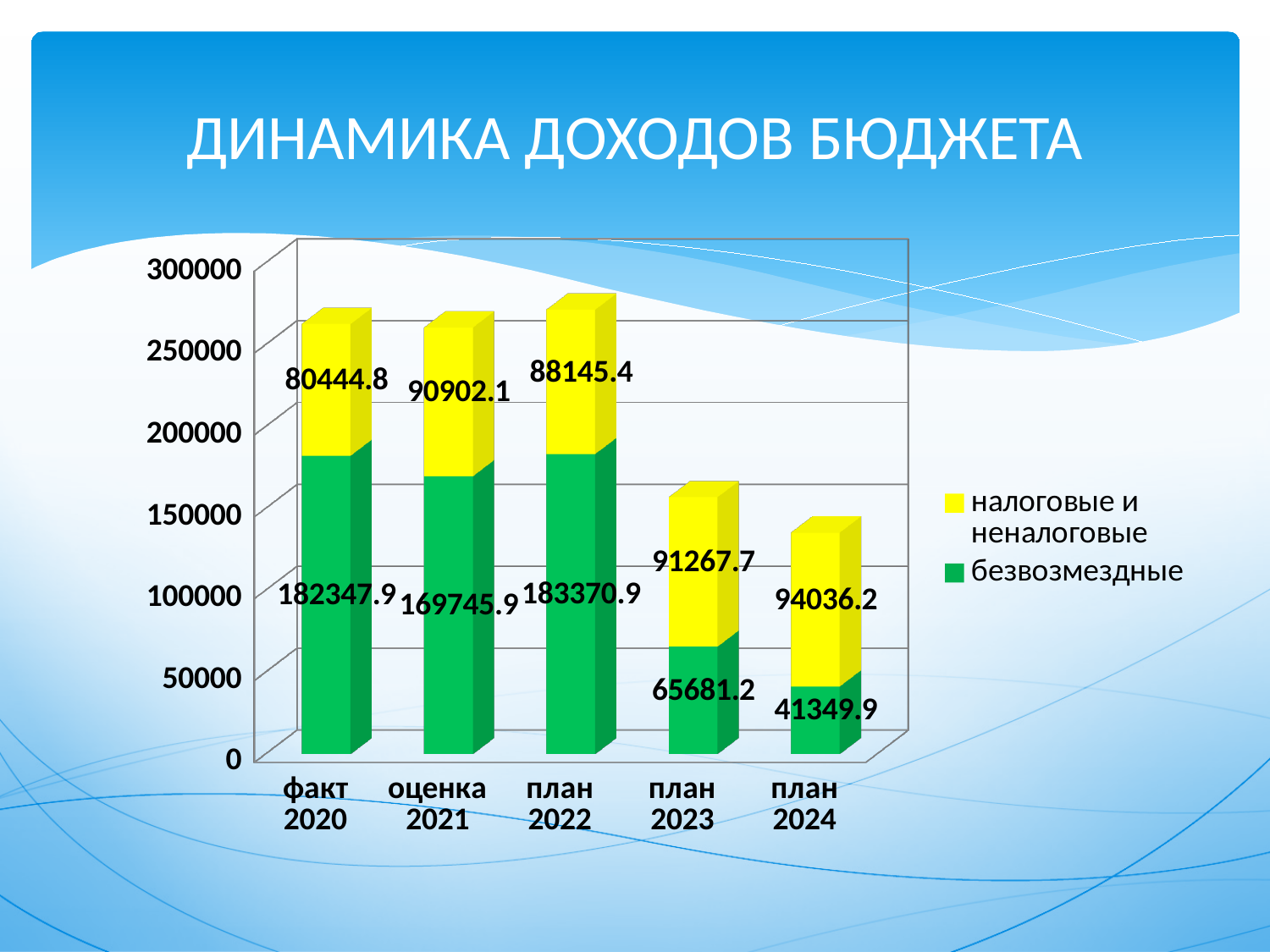
What kind of chart is shown on the slide? Stacked bar chart Which category has the highest value for налоговые и неналоговые? план 2024 What is the total of the stacked bar for план 2023? 156948.9 What is the value of безвозмездные for план 2024? 41349.9 What is the value of безвозмездные for факт 2020? 182347.9 Which is larger: безвозмездные for оценка 2021 or налоговые и неналоговые for оценка 2021? безвозмездные for оценка 2021 What is the difference between безвозмездные for план 2022 and план 2024? 142021.0 Which category has the lowest value for безвозмездные? план 2024 What is the title of the chart? ДИНАМИКА ДОХОДОВ БЮДЖЕТА What is the value of налоговые и неналоговые for план 2023? 91267.7 How many categories are shown on the x axis? 5 How many series does the legend list? 2